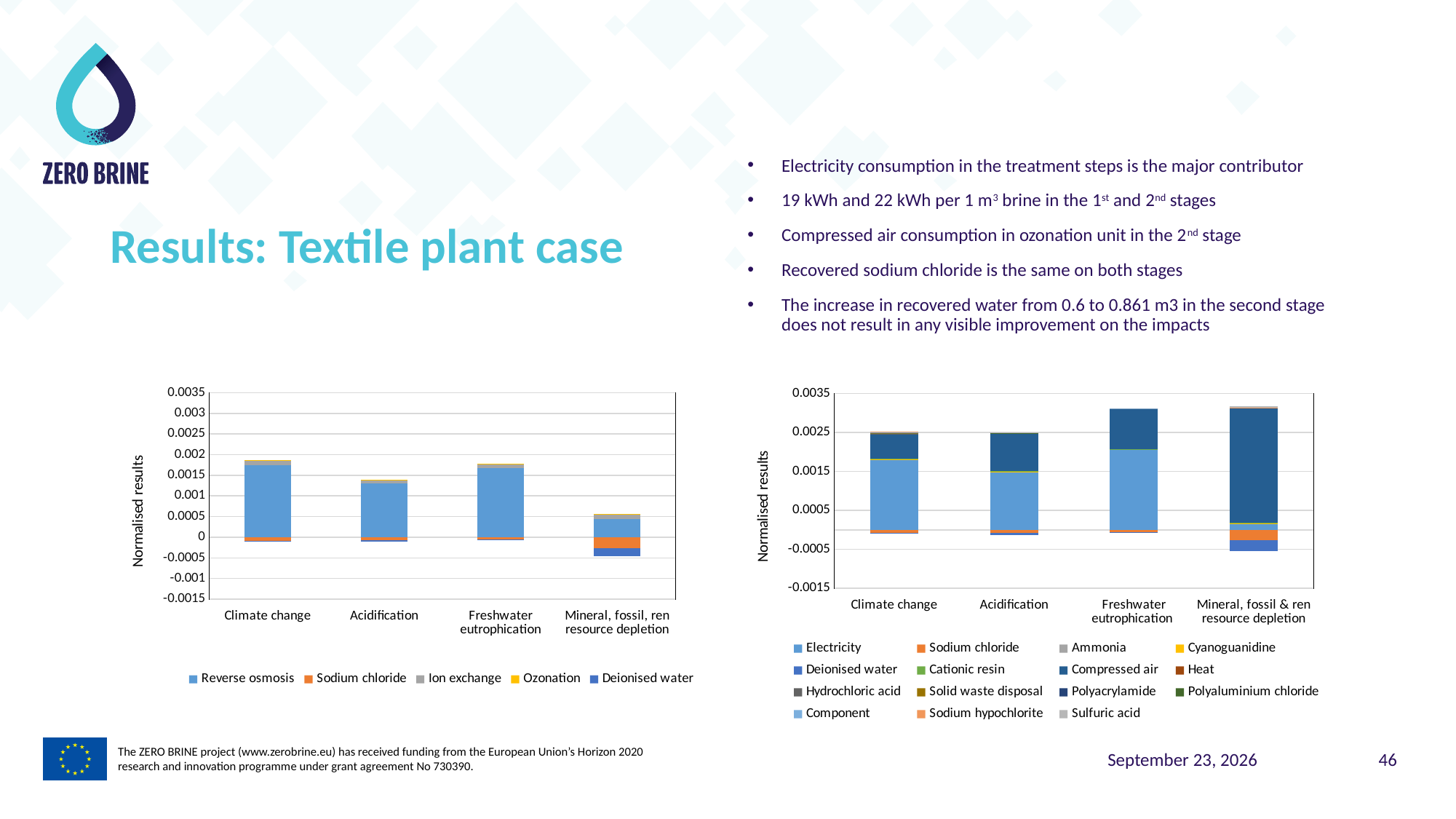
How many categories are shown on the x axis of the left chart? 4 In the right chart, which category has the largest Electricity value? Freshwater eutrophication In the left chart, which category has the smallest Reverse osmosis value? Mineral, fossil, ren resource depletion How many series does the legend of the right chart list? 15 In the right chart, is the Electricity value for Mineral, fossil & ren resource depletion greater or less than 0.0005? less In the right chart, is the Electricity value for Climate change greater or less than 0.0015? greater What is the y-axis title of the right chart? Normalised results How many series does the legend of the left chart list? 5 In the left chart, is the Reverse osmosis value for Climate change greater or less than 0.0015? greater What kind of chart is the left chart on the slide? Stacked bar chart In the right chart, which category has the largest Compressed air value? Mineral, fossil & ren resource depletion